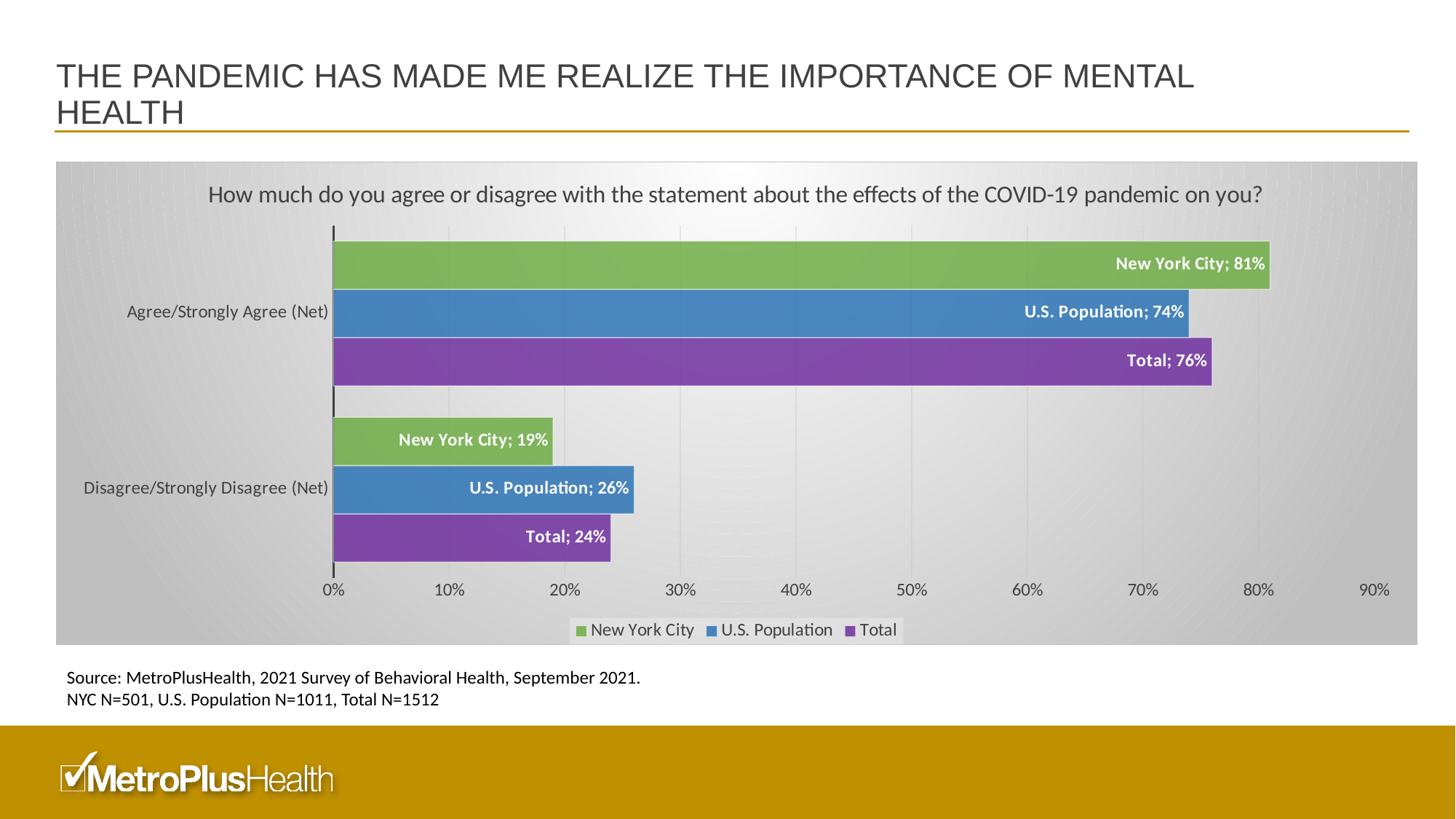
How many series does the legend list? 3 What is the value for U.S. Population in the Disagree/Strongly Disagree (Net) category? 26% What is the difference between the U.S. Population and Total values for Disagree/Strongly Disagree (Net)? 2% What is the difference between the New York City and U.S. Population values for Agree/Strongly Agree (Net)? 7% Which series has the highest value in the Agree/Strongly Agree (Net) category? New York City What colour are the bars for the Total series? Purple Which series has the lowest value in the Disagree/Strongly Disagree (Net) category? New York City Which is larger: the Total value for Agree/Strongly Agree (Net) or the U.S. Population value for Agree/Strongly Agree (Net)? Total What is the value for New York City in the Agree/Strongly Agree (Net) category? 81% What kind of chart is shown on the slide? Bar chart How many categories are shown on the vertical axis? 2 What is the Total value for Agree/Strongly Agree (Net)? 76%